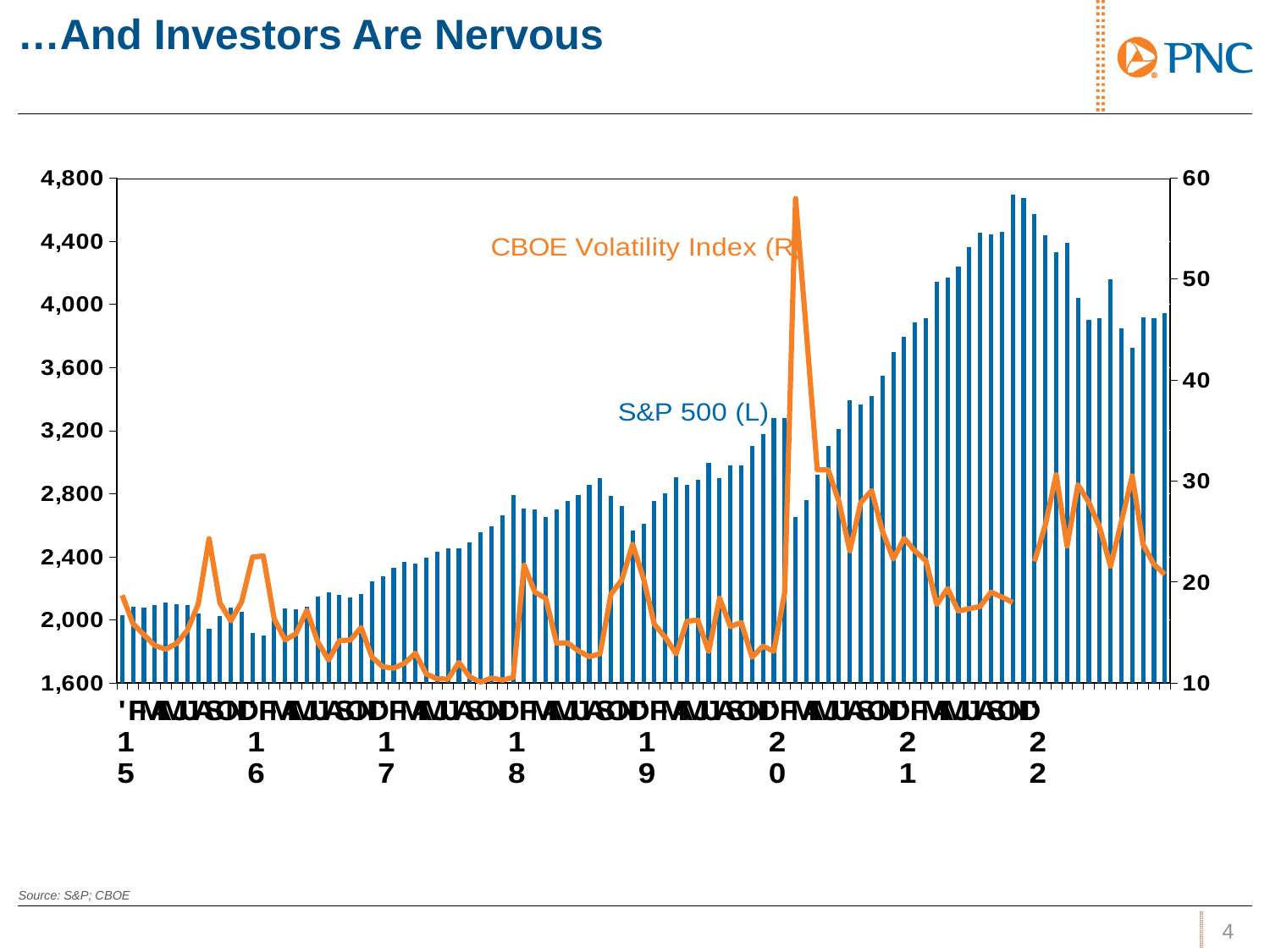
In which year does the CBOE Volatility Index spike to its highest value? 2020 What kind of chart is shown on the slide? A combined bar and line chart Is the CBOE Volatility Index value at the end of the series in 2022 greater or less than 30? less Is the highest S&P 500 bar greater or less than 4,400? greater Is the peak value of the CBOE Volatility Index greater or less than 50? greater Do the S&P 500 bars generally rise or fall from 2015 to 2022? Rise Which series is plotted against the right-hand axis? CBOE Volatility Index What colour is the CBOE Volatility Index line? Orange How many data series are plotted on the chart? 2